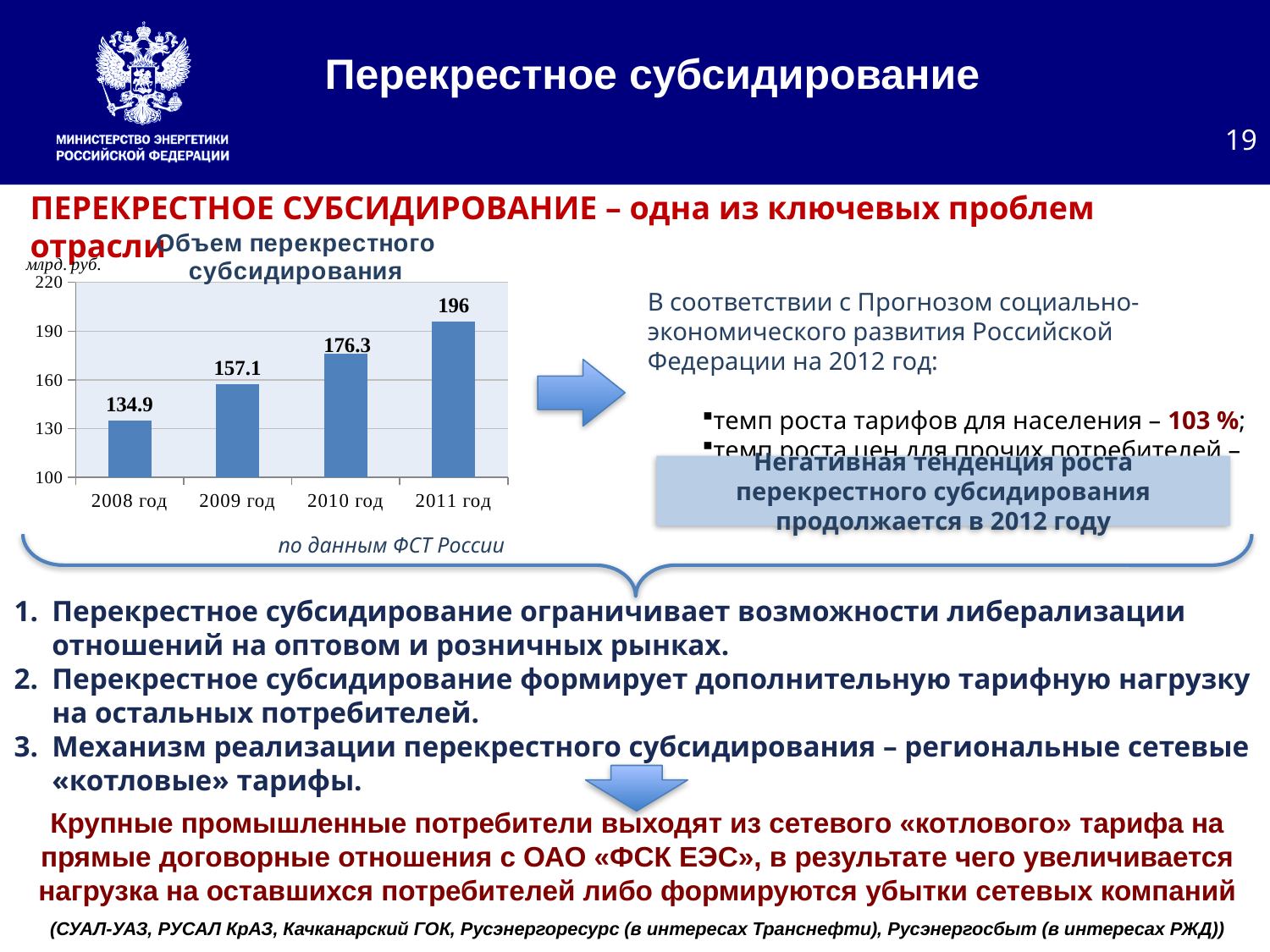
What is the difference between the values for 2009 год and 2008 год? 22.2 What is the value for 2011 год in the chart? 196 Which is larger, the value for 2009 год or the value for 2010 год? 2010 год What is the value for 2010 год in the chart? 176.3 Do the values rise or fall from 2008 год to 2011 год? rise What kind of chart is shown on the slide? bar chart How many years are shown in the chart? 4 What is the difference between the values for 2011 год and 2008 год? 61.1 Is the value for 2009 год greater or less than 160? less Which year has the lowest value in the chart? 2008 год What is the value for 2008 год in the chart? 134.9 Which year has the highest value in the chart? 2011 год